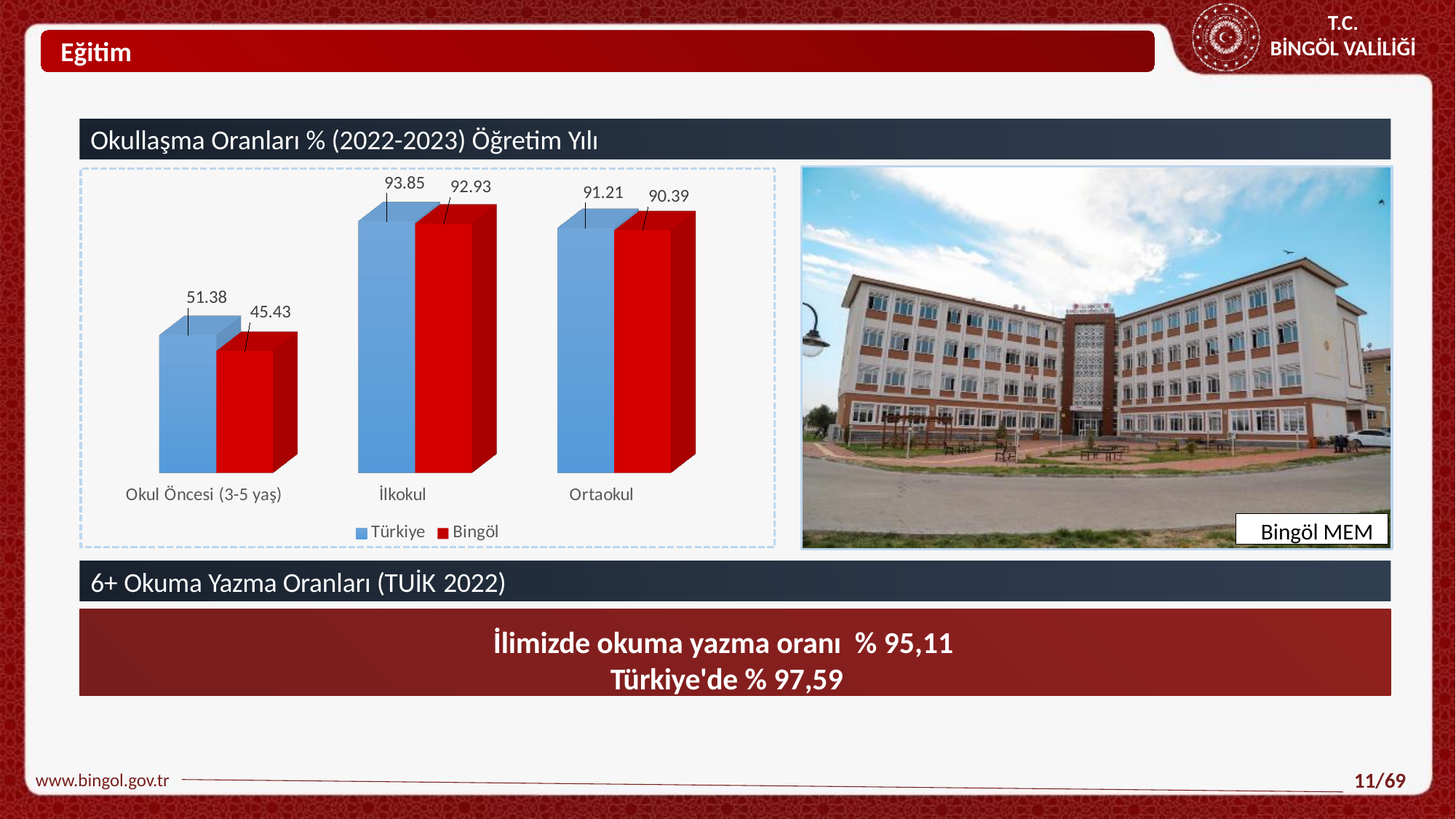
What is the difference between the Türkiye and Bingöl values for Okul Öncesi (3-5 yaş)? 5.95 How many series does the chart legend list? 2 Which category has the lowest Bingöl value? Okul Öncesi (3-5 yaş) How many categories are shown on the x axis of the chart? 3 What is the Türkiye value for Ortaokul? 91.21 What is the Bingöl value for İlkokul? 92.93 What is the Bingöl value for Ortaokul? 90.39 What kind of chart is shown on the slide? Bar chart Which colour represents Bingöl in the chart? Red Which is larger for İlkokul, the Türkiye value or the Bingöl value? Türkiye What is the Türkiye value for Okul Öncesi (3-5 yaş)? 51.38 Which category has the highest Türkiye value? İlkokul